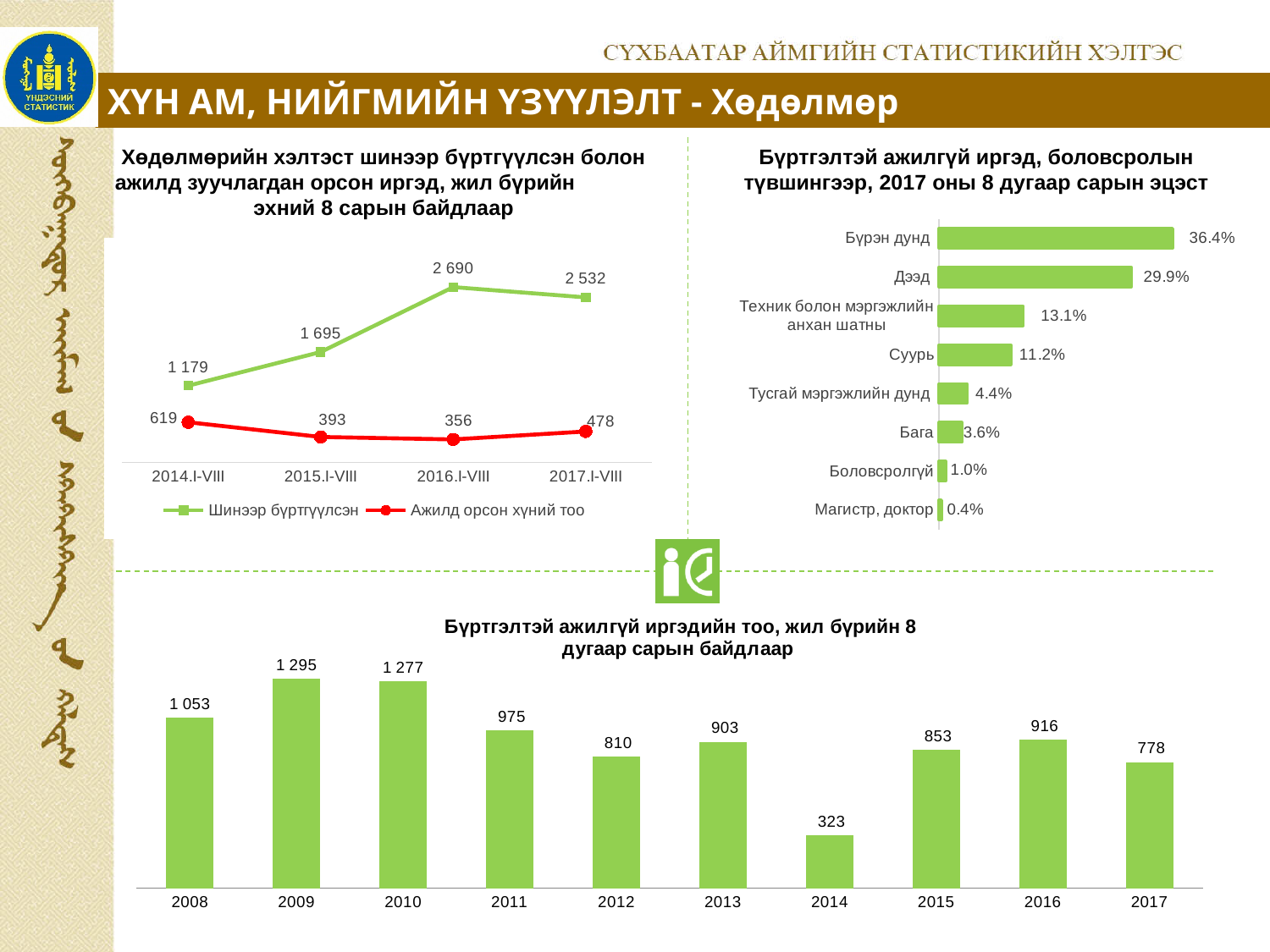
In the top-right chart (Бүртгэлтэй ажилгүй иргэд, боловсролын түвшингээр), what is the value for Дээд? 29.9% In the top-left line chart, what is the value for Ажилд орсон хүний тоо in 2014.I-VIII? 619 In the bottom chart, which year has the highest number of registered unemployed? 2009 In the top-left line chart, what is the difference between Шинээр бүртгүүлсэн and Ажилд орсон хүний тоо in 2017.I-VIII? 2 054 In the top-left chart (Хөдөлмөрийн хэлтэст шинээр бүртгүүлсэн болон ажилд зуучлагдан орсон иргэд), what is the value for Шинээр бүртгүүлсэн in 2016.I-VIII? 2 690 In the bottom chart (Бүртгэлтэй ажилгүй иргэдийн тоо), what is the value for 2014? 323 In the top-right chart, which education level has the lowest share? Магистр, доктор What type of chart is the bottom chart (Бүртгэлтэй ажилгүй иргэдийн тоо)? bar chart In the top-left line chart, in which period is Ажилд орсон хүний тоо lowest? 2016.I-VIII How many series does the legend of the top-left line chart list? 2 In the top-right chart, which education level has the highest share? Бүрэн дунд In the top-right chart, how many education categories are shown? 8